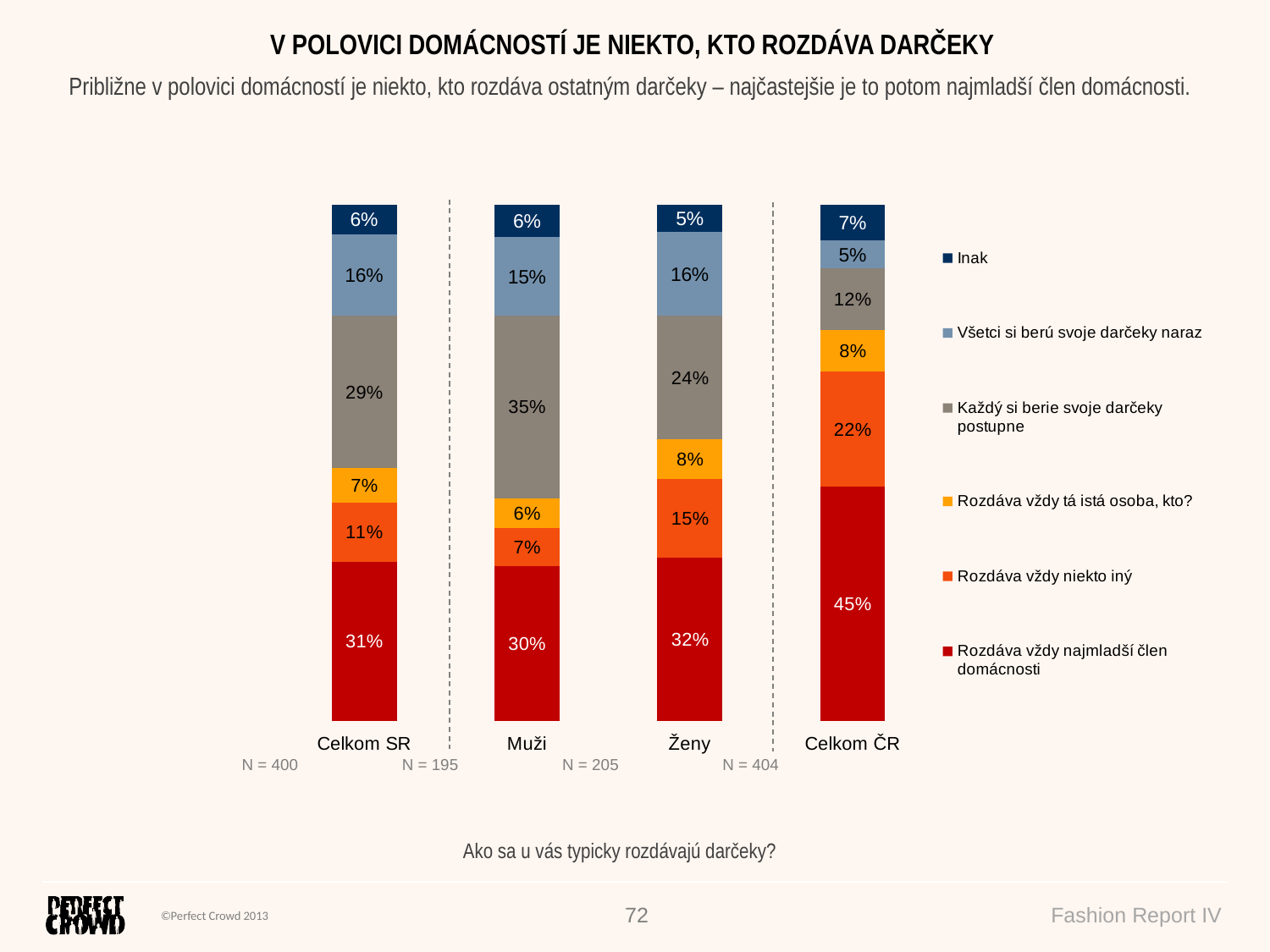
Which category has the highest value for 'Rozdáva vždy najmladší člen domácnosti'? Celkom ČR How many categories (bars) are shown on the x axis of the chart? 4 How many series does the chart's legend list? 6 What is the value for 'Rozdáva vždy najmladší člen domácnosti' in the Celkom ČR bar? 45% What kind of chart is shown on the slide? stacked bar chart Which category has the lowest value for 'Každý si berie svoje darčeky postupne'? Celkom ČR What is the value for 'Rozdáva vždy niekto iný' in the Ženy bar? 15% What is the value for 'Všetci si berú svoje darčeky naraz' in the Celkom SR bar? 16% What is the difference between the 'Rozdáva vždy niekto iný' values for Celkom ČR and Celkom SR? 11% What is the value for 'Každý si berie svoje darčeky postupne' in the Muži bar? 35% Which is larger: the 'Každý si berie svoje darčeky postupne' value for Muži or for Ženy? Muži What is the sample size (N) shown for the Ženy category? N = 205